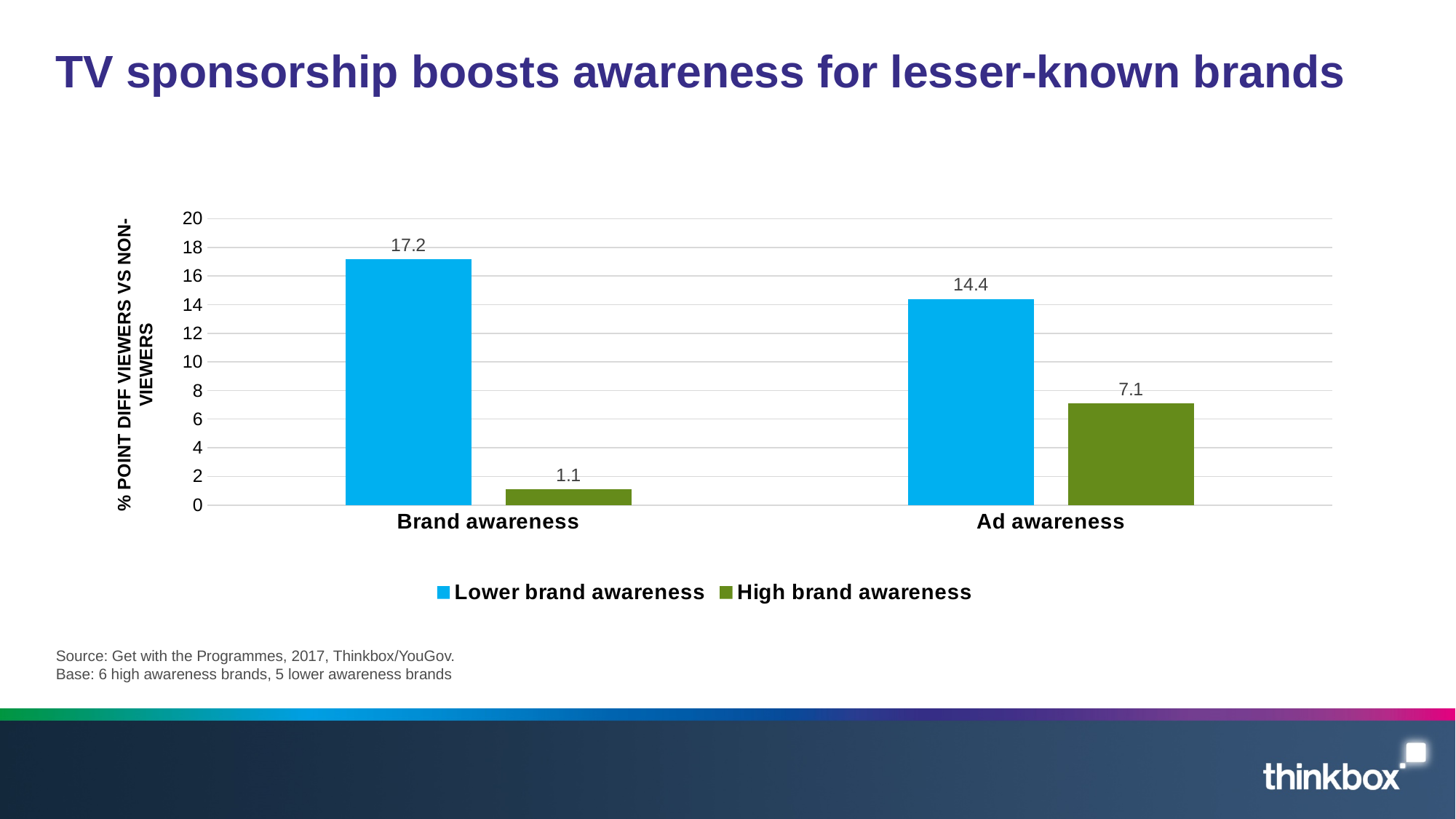
Which bar has the lowest value on the chart? High brand awareness, Brand awareness What is the value for High brand awareness in the Brand awareness category? 1.1 What is the value for Lower brand awareness in the Ad awareness category? 14.4 Which is larger: the High brand awareness value for Ad awareness or for Brand awareness? Ad awareness What is the value for High brand awareness in the Ad awareness category? 7.1 What is the difference between the Lower brand awareness and High brand awareness values in the Brand awareness category? 16.1 How many series does the legend list? 2 What is the value for Lower brand awareness in the Brand awareness category? 17.2 What kind of chart is shown on the slide? Bar chart Which bar has the highest value on the chart? Lower brand awareness, Brand awareness What is the difference between the Lower brand awareness and High brand awareness values in the Ad awareness category? 7.3 How many categories are shown on the x axis? 2